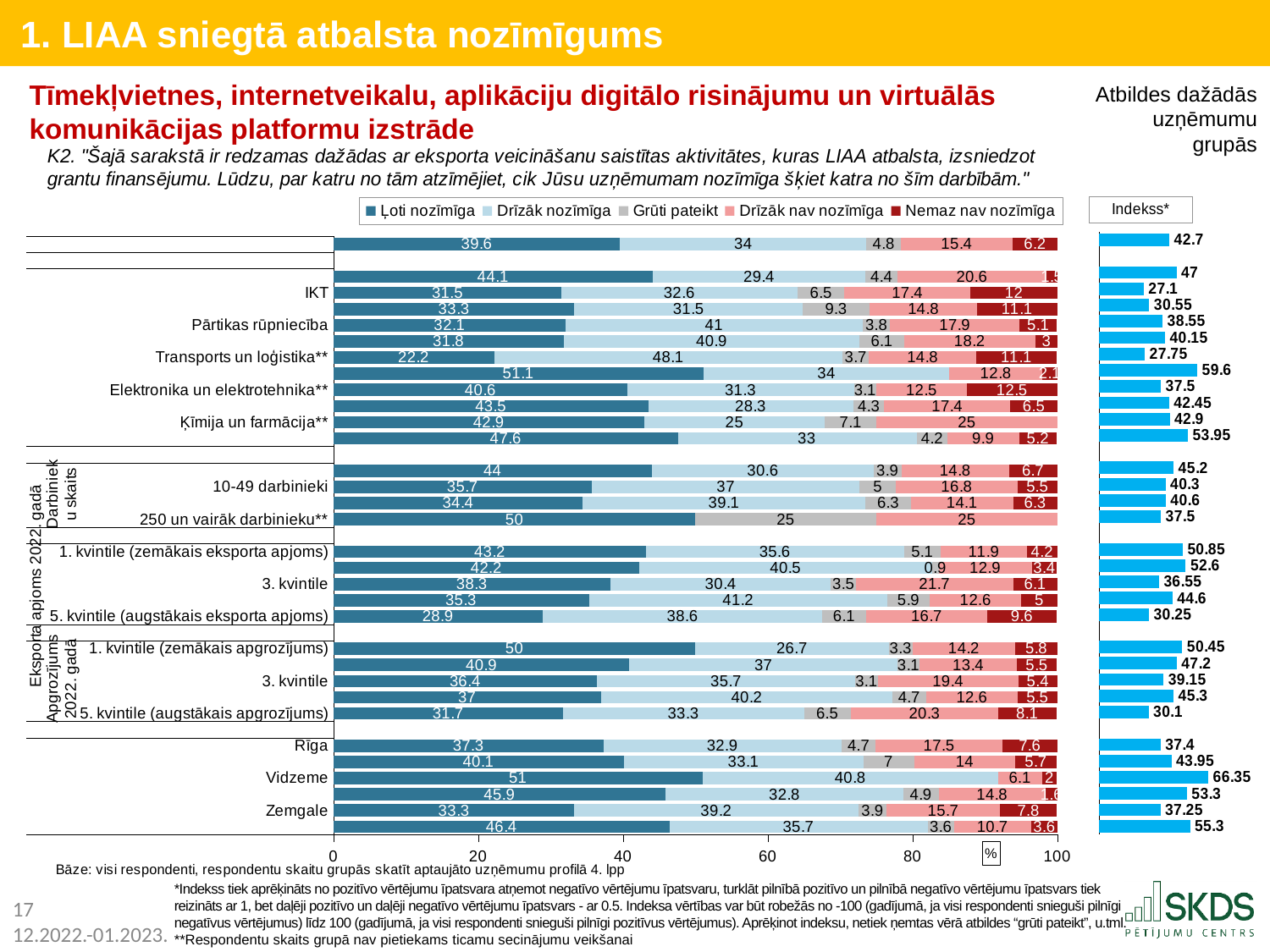
In the Indekss* chart, what is the index value for 1. kvintile (zemākais apgrozījums)? 50.45 In the main chart, what is the 'Grūti pateikt' value for Ķīmija un farmācija**? 7.1 In the main chart, what is the difference between the 'Ļoti nozīmīga' values for 1. kvintile (zemākais eksporta apjoms) and 5. kvintile (augstākais eksporta apjoms)? 14.3 In the Indekss* chart, what is the index value for Vidzeme? 66.35 In the main chart, what is the 'Nemaz nav nozīmīga' value for IKT? 12 What kind of chart is the main chart on the slide? Stacked bar chart In the main chart, what is the 'Ļoti nozīmīga' value for Vidzeme? 51 In the Indekss* chart, which is larger: the index for IKT or for Pārtikas rūpniecība? Pārtikas rūpniecība In the main chart, what is the 'Drīzāk nav nozīmīga' value for 5. kvintile (augstākais apgrozījums)? 20.3 In the main chart, which is larger: the 'Ļoti nozīmīga' value for Rīga or for Zemgale? Rīga In the main chart, what is the 'Drīzāk nozīmīga' value for Transports un loģistika**? 48.1 How many series does the legend of the main chart list? 5